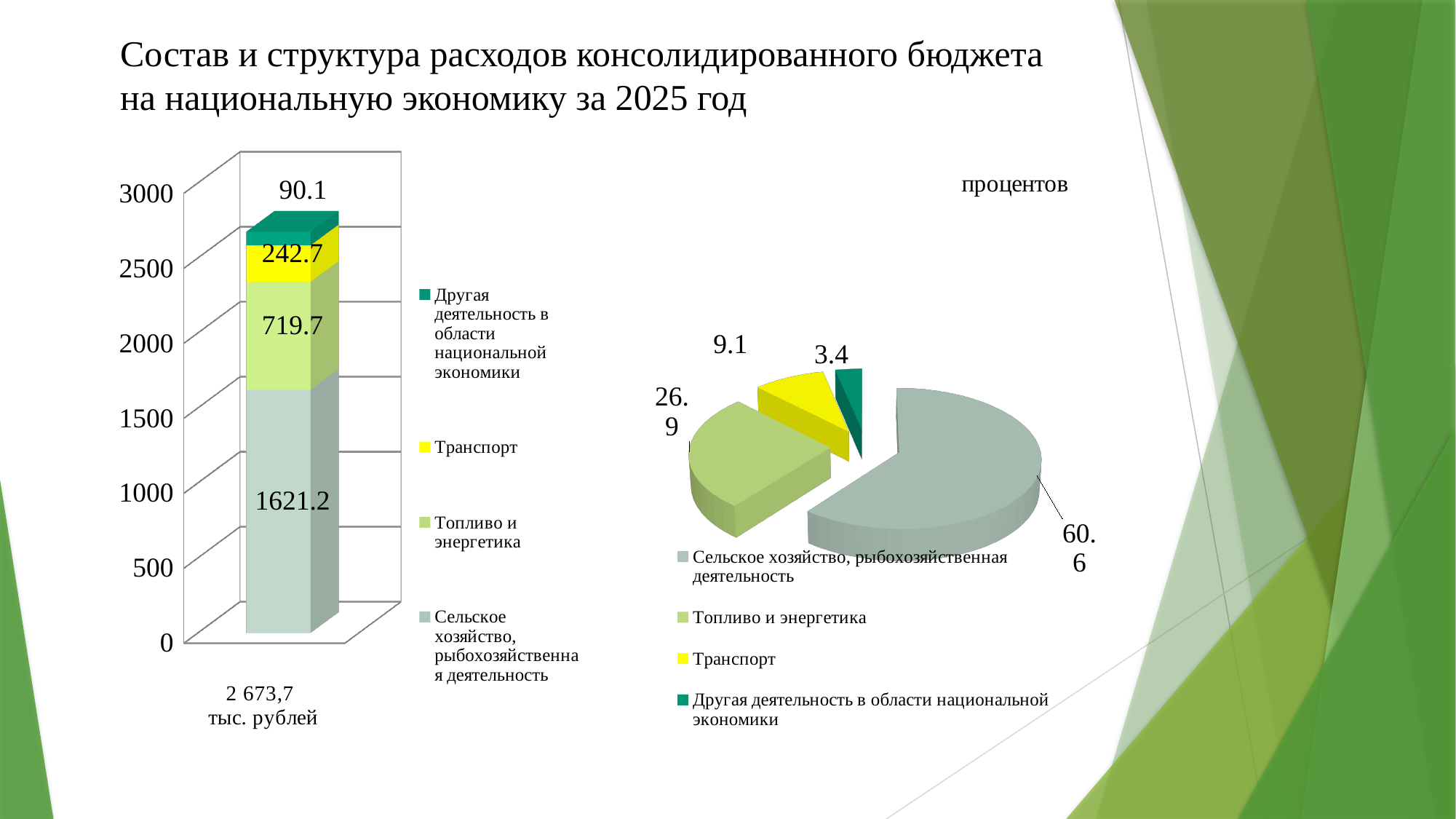
In the pie chart on the right, which is larger: Транспорт or Другая деятельность в области национальной экономики? Транспорт In the pie chart on the right, what is the value shown for Топливо и энергетика? 26.9 In the stacked bar chart on the left, what is the total of the stacked bar? 2 673,7 тыс. рублей In the pie chart on the right, what share does Транспорт have? 9.1 What kind of chart is the chart on the right of the slide? Pie chart In the stacked bar chart on the left, what is the difference between the values for Сельское хозяйство, рыбохозяйственная деятельность and Топливо и энергетика? 901.5 How many series does the legend of the stacked bar chart on the left list? 4 In the stacked bar chart on the left, which category has the largest segment? Сельское хозяйство, рыбохозяйственная деятельность In the stacked bar chart on the left, what is the value for Транспорт? 242.7 In the pie chart on the right, which category has the smallest slice? Другая деятельность в области национальной экономики In the stacked bar chart on the left, what is the value for Топливо и энергетика? 719.7 What unit label is shown above the pie chart on the right? процентов